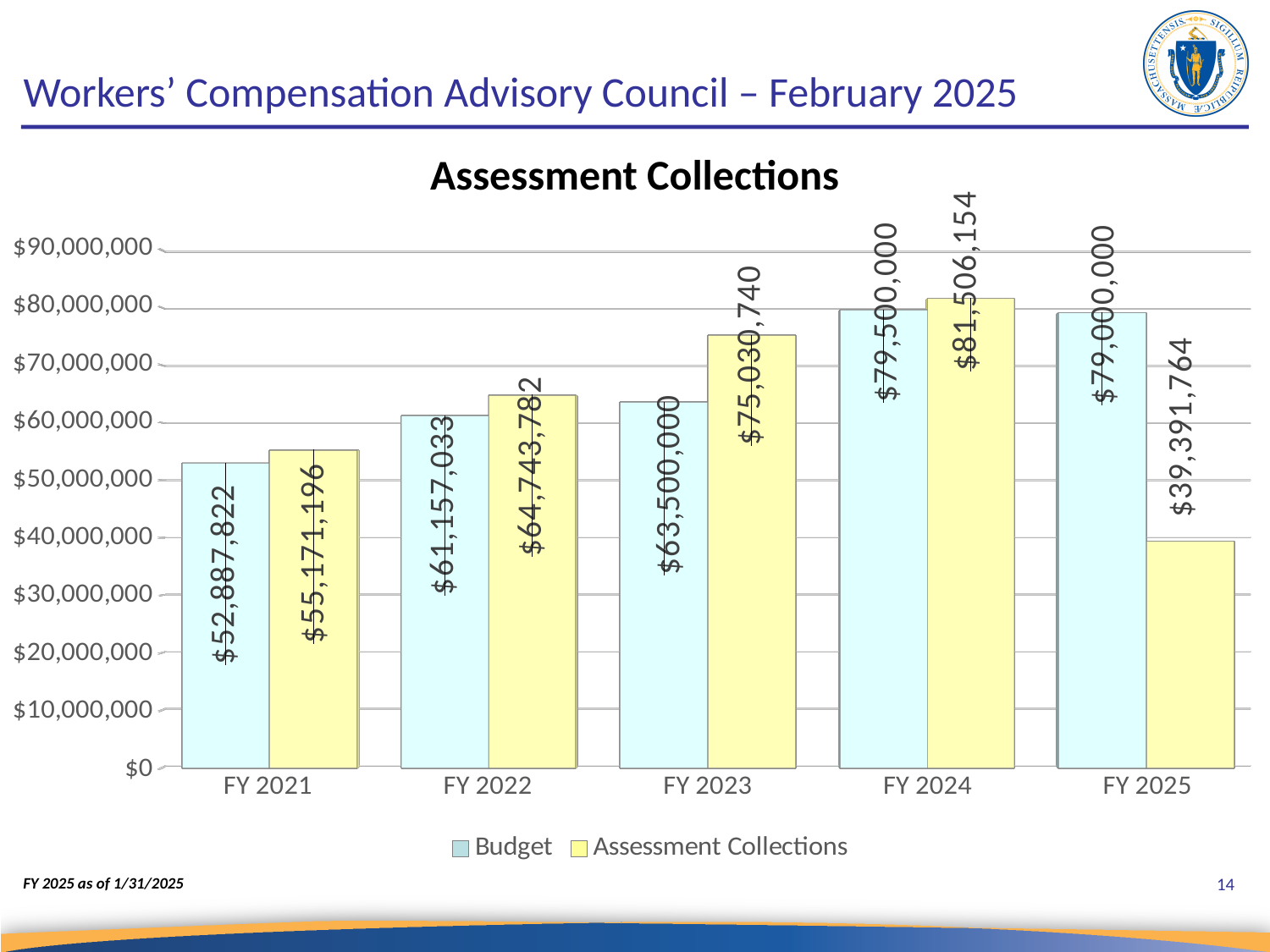
What is the Budget value for FY 2023? $63,500,000 What is the Budget value for FY 2021? $52,887,822 What is the Assessment Collections value for FY 2022? $64,743,782 Which fiscal year has the lowest Assessment Collections value? FY 2025 What type of chart is shown on the slide? Bar chart What is the Assessment Collections value for FY 2025? $39,391,764 What is the difference between Assessment Collections and Budget for FY 2023? $11,530,740 In FY 2024, which is larger: Budget or Assessment Collections? Assessment Collections Which fiscal year has the highest Assessment Collections value? FY 2024 How many fiscal years are shown on the x axis? 5 By how much does the Budget exceed Assessment Collections in FY 2025? $39,608,236 How many series does the legend list? 2